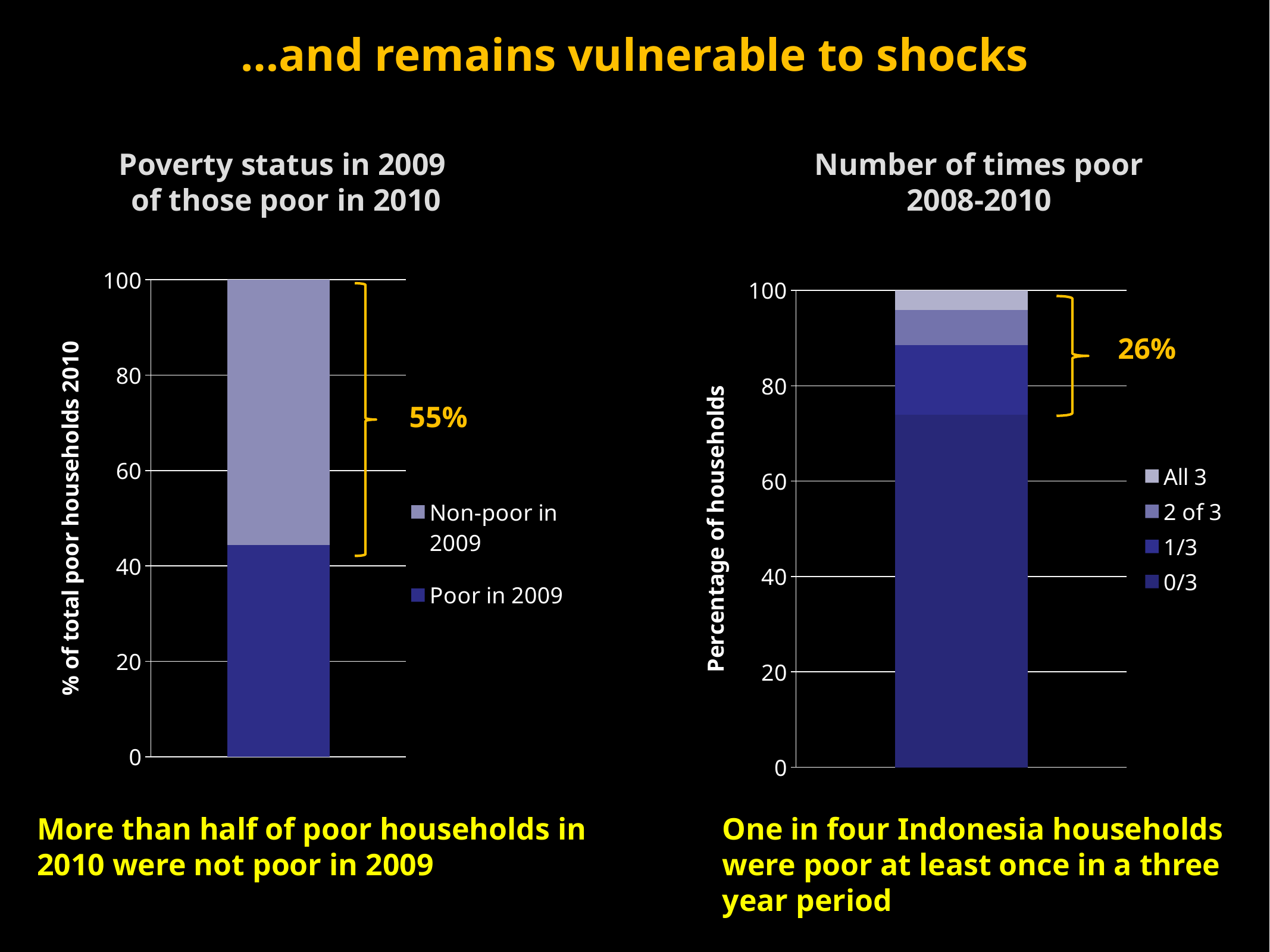
What is the y-axis label of the left chart? % of total poor households 2010 On the right chart, 'Number of times poor 2008-2010', what percentage is labelled by the bracket covering the top three segments? 26% On the left chart, is the value for Poor in 2009 greater or less than 50? less On the left chart, 'Poverty status in 2009 of those poor in 2010', what percentage is labelled for the Non-poor in 2009 segment? 55% What is the y-axis label of the right chart? Percentage of households On the right chart, which series has the largest segment? 0/3 How many series does the legend of the left chart list? 2 How many series does the legend of the right chart list? 4 What kind of chart is the right chart, 'Number of times poor 2008-2010'? Stacked bar chart On the left chart, which segment is larger, Non-poor in 2009 or Poor in 2009? Non-poor in 2009 On the right chart, which series has the smallest segment? All 3 On the right chart, is the value for 0/3 greater or less than 60? greater